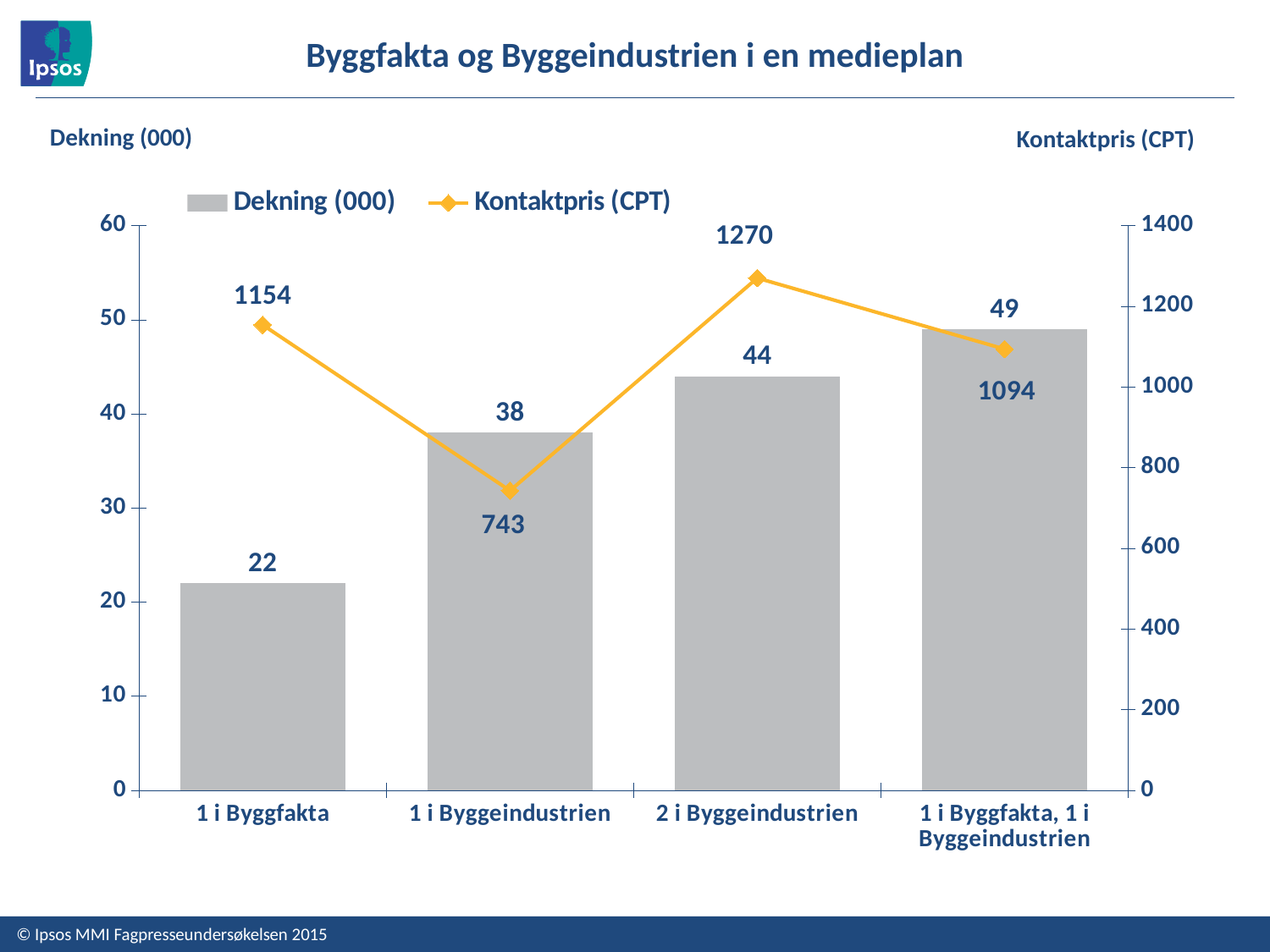
What is the Dekning (000) value for 1 i Byggfakta? 22 How many categories are shown on the x axis? 4 Which has a higher Kontaktpris (CPT): 1 i Byggfakta or 1 i Byggfakta, 1 i Byggeindustrien? 1 i Byggfakta Does the Dekning (000) series rise or fall from left to right across the categories? rise How many series does the legend list? 2 What is the difference in Kontaktpris (CPT) between 2 i Byggeindustrien and 1 i Byggfakta, 1 i Byggeindustrien? 176 Which category has the lowest Kontaktpris (CPT)? 1 i Byggeindustrien What is the Kontaktpris (CPT) value for 1 i Byggeindustrien? 743 What is the title of the chart? Byggfakta og Byggeindustrien i en medieplan What is the Kontaktpris (CPT) value for 2 i Byggeindustrien? 1270 Which category has the highest Dekning (000)? 1 i Byggfakta, 1 i Byggeindustrien What is the difference in Dekning (000) between 2 i Byggeindustrien and 1 i Byggfakta? 22